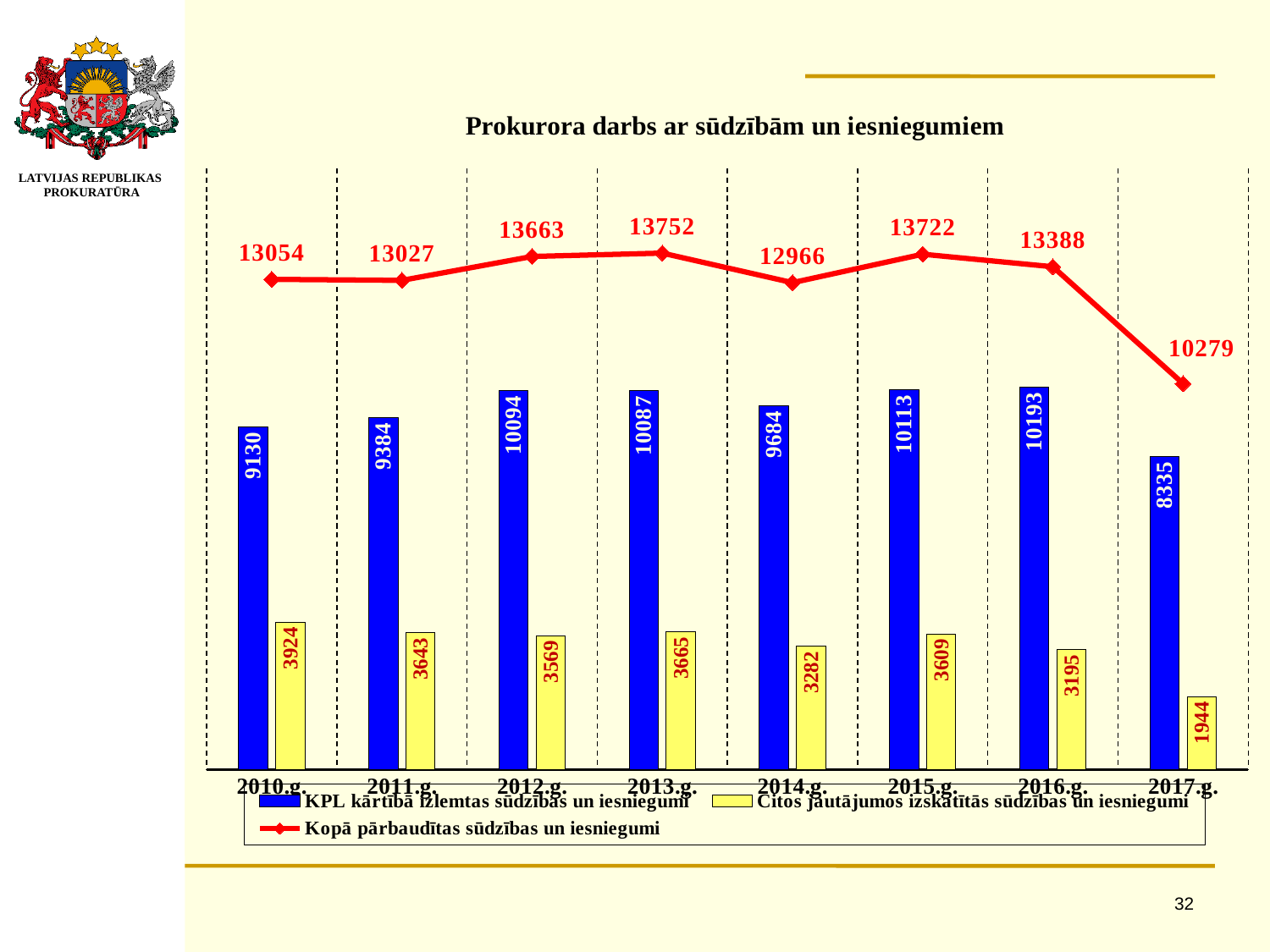
What kind of chart is shown on the slide? Combined bar and line chart Does the yellow bar series (Citos jautājumos izskatītās sūdzības un iesniegumi) rise or fall from 2015.g. to 2017.g.? Fall How many years are shown on the x axis? 8 What is the value of the yellow bar (Citos jautājumos izskatītās sūdzības un iesniegumi) for 2014.g.? 3282 What is the difference between the red line values for 2016.g. and 2017.g.? 3109 In which year is the yellow bar (Citos jautājumos izskatītās sūdzības un iesniegumi) highest? 2010.g. What is the title of the chart? Prokurora darbs ar sūdzībām un iesniegumiem How many series does the legend list? 3 What is the value of the blue bar (KPL kārtībā izlemtas sūdzības un iesniegumi) for 2016.g.? 10193 What is the value of the red line (Kopā pārbaudītas sūdzības un iesniegumi) for 2013.g.? 13752 Which is larger: the blue bar for 2012.g. or the blue bar for 2017.g.? 2012.g. In which year is the red line (Kopā pārbaudītas sūdzības un iesniegumi) lowest? 2017.g.